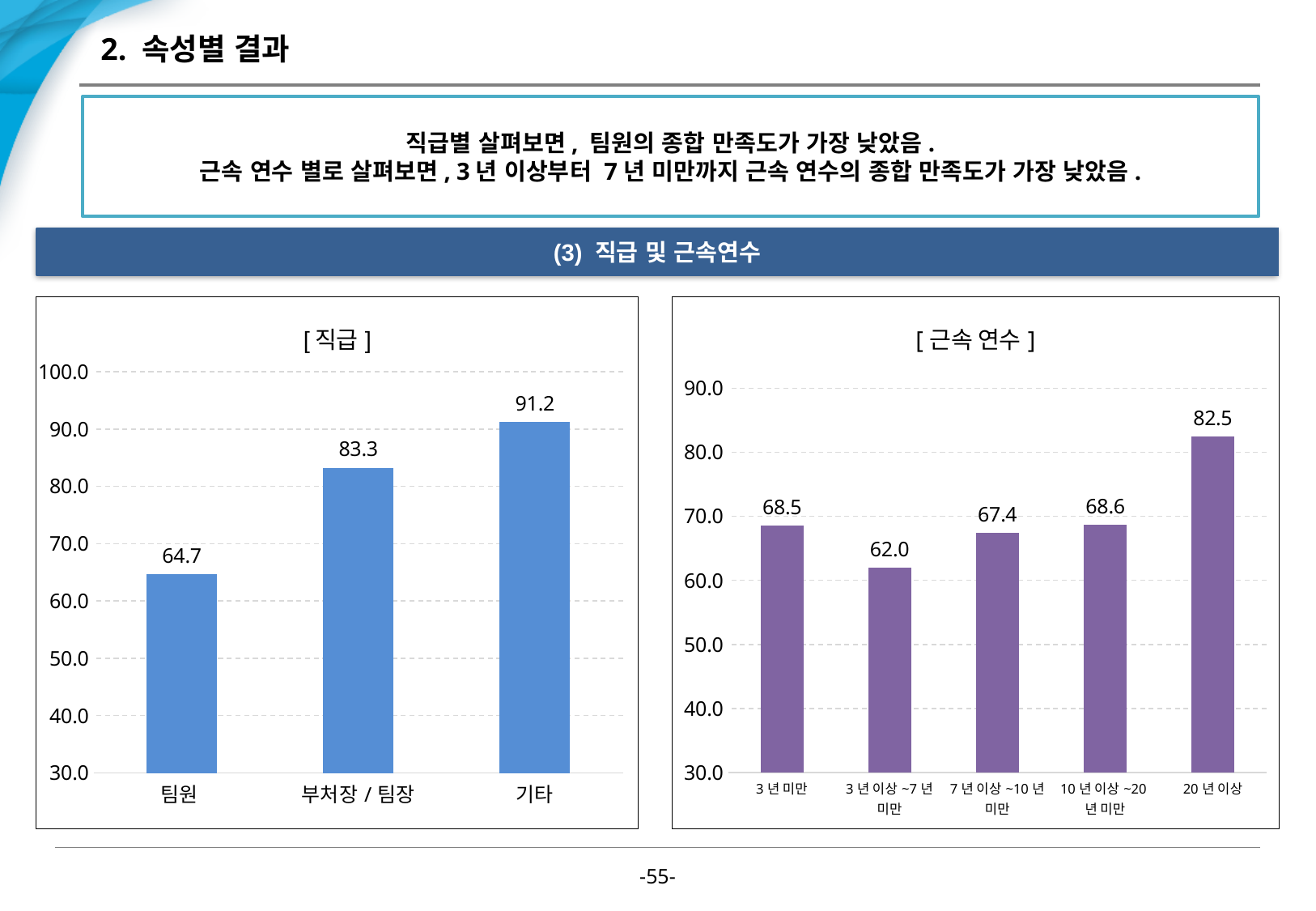
In the [근속 연수] chart, how many categories are shown? 5 In the [근속 연수] chart, which is larger, the value for 7 년 이상 ~10 년 미만 or the value for 20 년 이상? 20 년 이상 In the [직급] chart, what is the difference between the values for 기타 and 팀원? 26.5 In the [직급] chart, which category has the highest value? 기타 In the [근속 연수] chart, what is the difference between the values for 20 년 이상 and 3 년 이상 ~7 년 미만? 20.5 In the [근속 연수] chart, what is the value for 3 년 이상 ~7 년 미만? 62.0 In the [근속 연수] chart, which category has the lowest value? 3 년 이상 ~7 년 미만 In the [직급] chart, what is the value for 부처장 / 팀장? 83.3 What kind of chart is the [직급] chart? bar chart In the [직급] chart, how many categories are shown? 3 In the [근속 연수] chart, what is the value for 20 년 이상? 82.5 In the [직급] chart, what is the value for 팀원? 64.7